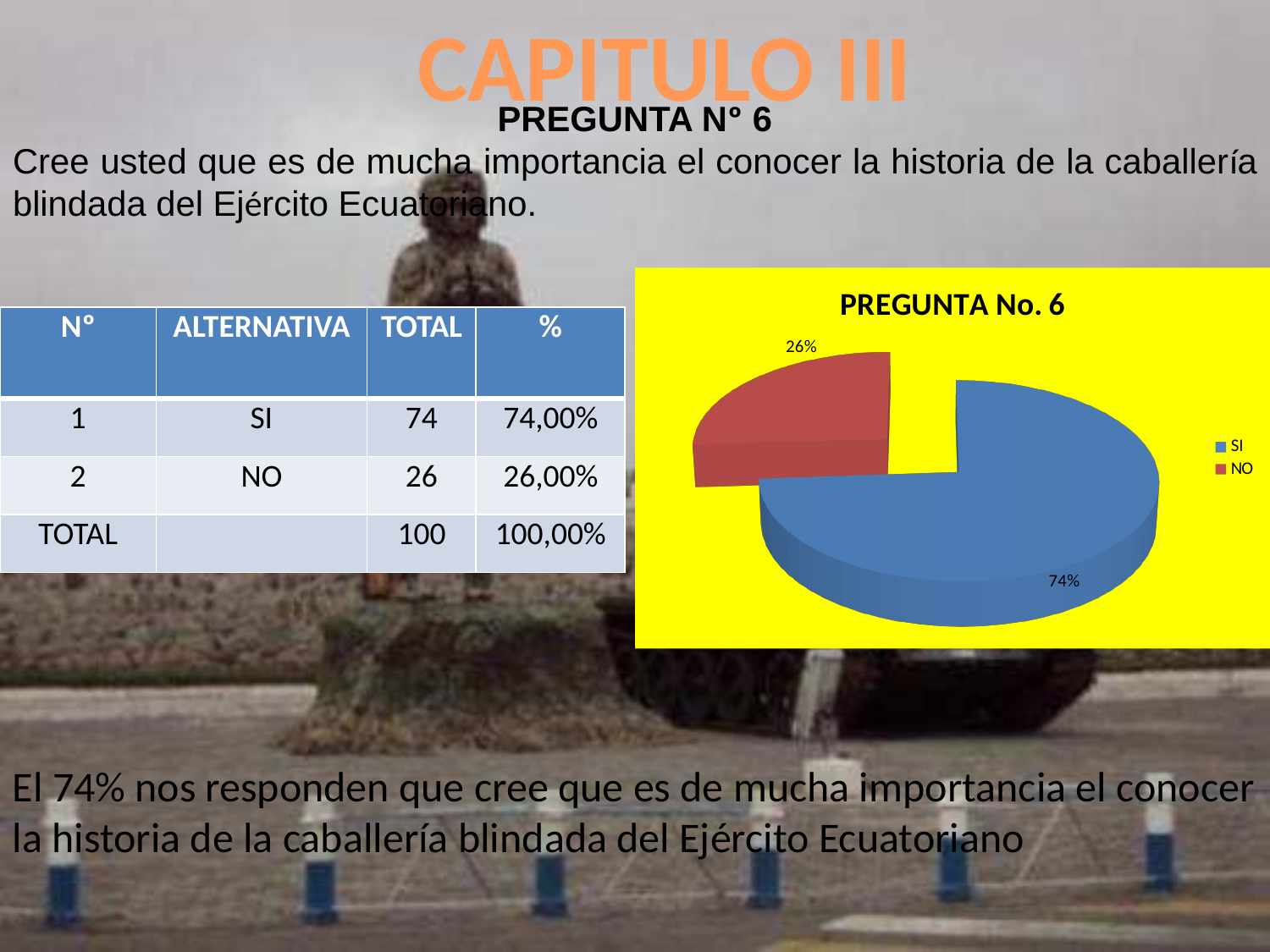
What type of chart is shown on the slide? pie chart Which category has the largest slice in the chart? SI What percentage does the SI slice show in the chart? 74% How many slices does the pie chart have? 2 Which category has the smallest slice in the chart? NO Is the value for NO greater or less than 50%? less What is the title of the chart? PREGUNTA No. 6 Which slice is larger, SI or NO? SI How many entries does the chart legend list? 2 What colour is the SI slice in the chart? blue What is the difference in percentage points between the SI and NO slices? 48 What percentage does the NO slice show in the chart? 26%